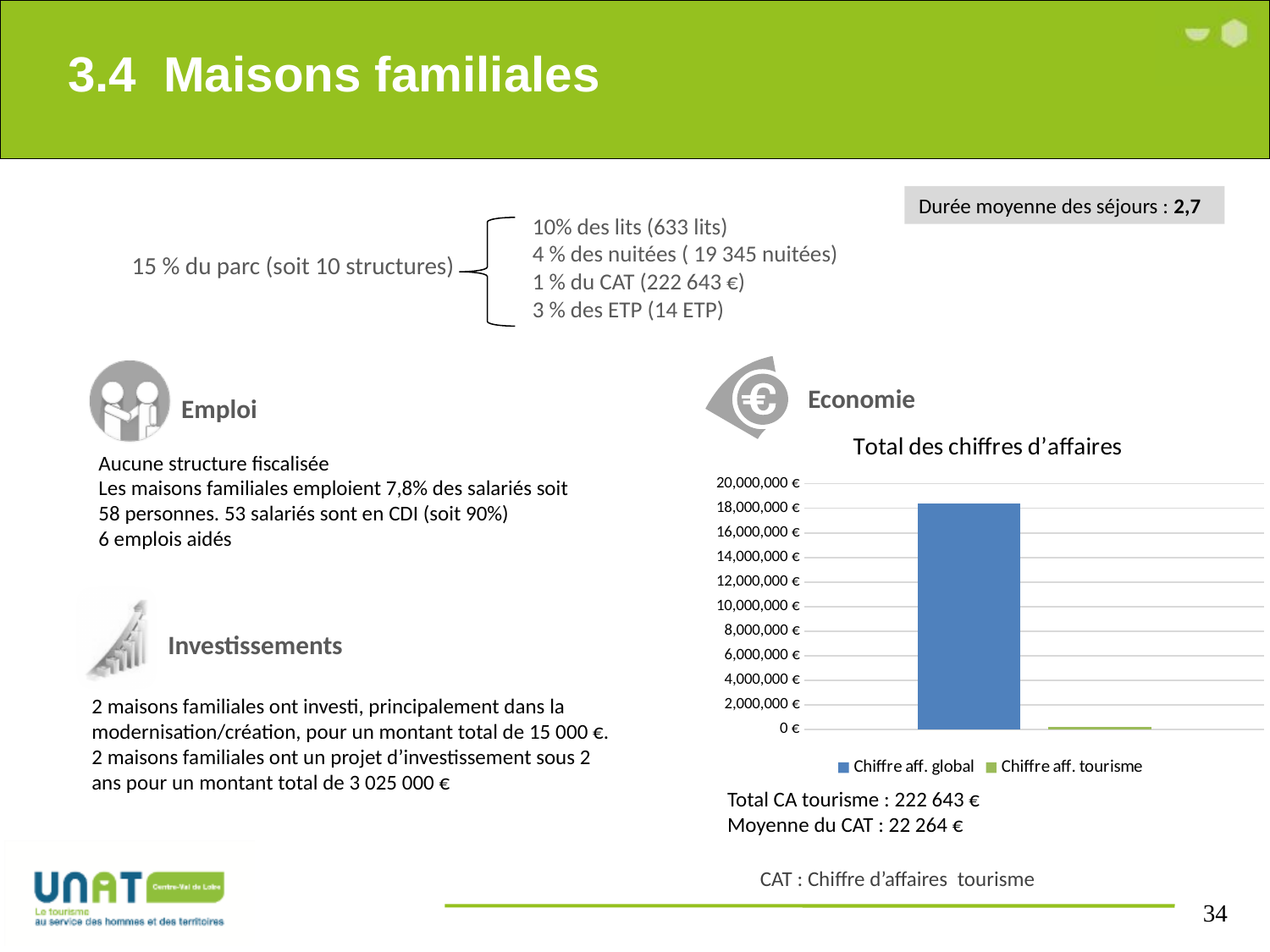
Which series has the lowest value in the "Total des chiffres d'affaires" chart? Chiffre aff. tourisme In the "Total des chiffres d'affaires" chart, which is larger: Chiffre aff. global or Chiffre aff. tourisme? Chiffre aff. global What is the title of the chart on the slide? Total des chiffres d'affaires In the "Total des chiffres d'affaires" chart, is the value for Chiffre aff. global greater or less than 16,000,000 €? greater In the "Total des chiffres d'affaires" chart, is the value for Chiffre aff. tourisme greater or less than 2,000,000 €? less Which series has the highest value in the "Total des chiffres d'affaires" chart? Chiffre aff. global In the "Total des chiffres d'affaires" chart, is the value for Chiffre aff. global greater or less than 20,000,000 €? less What colour is the Chiffre aff. global bar in the "Total des chiffres d'affaires" chart? blue How many bars are plotted in the "Total des chiffres d'affaires" chart? 2 What kind of chart is shown under the title "Total des chiffres d'affaires"? bar chart How many series does the legend of the "Total des chiffres d'affaires" chart list? 2